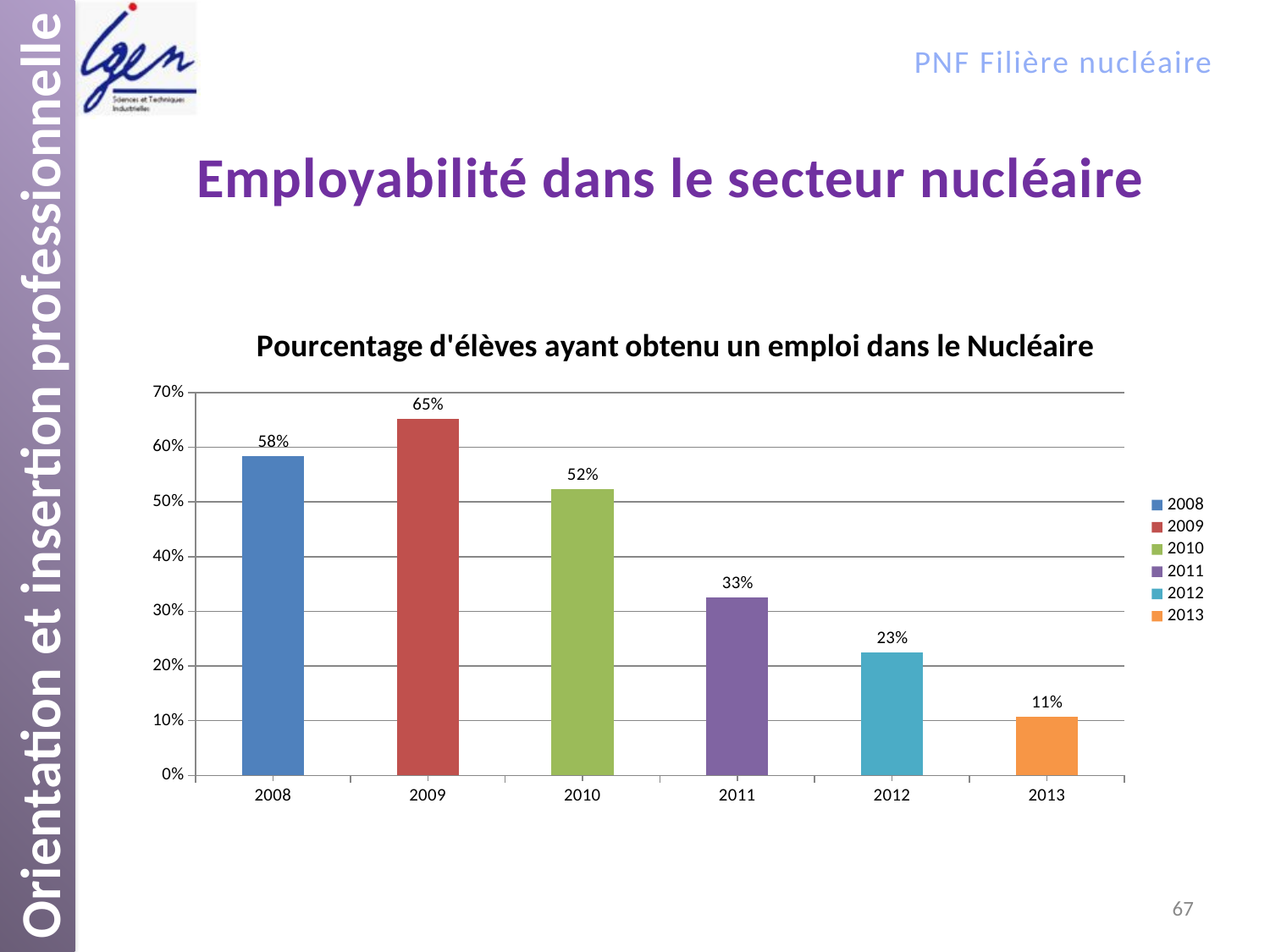
How many years are shown on the x axis? 6 Is the value for 2011 greater or less than 40%? less Which is larger, the value for 2010 or the value for 2012? 2010 What is the value for 2012? 23% What kind of chart is shown? bar chart Which year has the highest percentage? 2009 What is the value for 2009? 65% What is the difference between the values for 2008 and 2011? 25% Which year has the lowest percentage? 2013 What is the value for 2013? 11% Do the values rise or fall from 2009 to 2013? fall How many entries does the legend list? 6